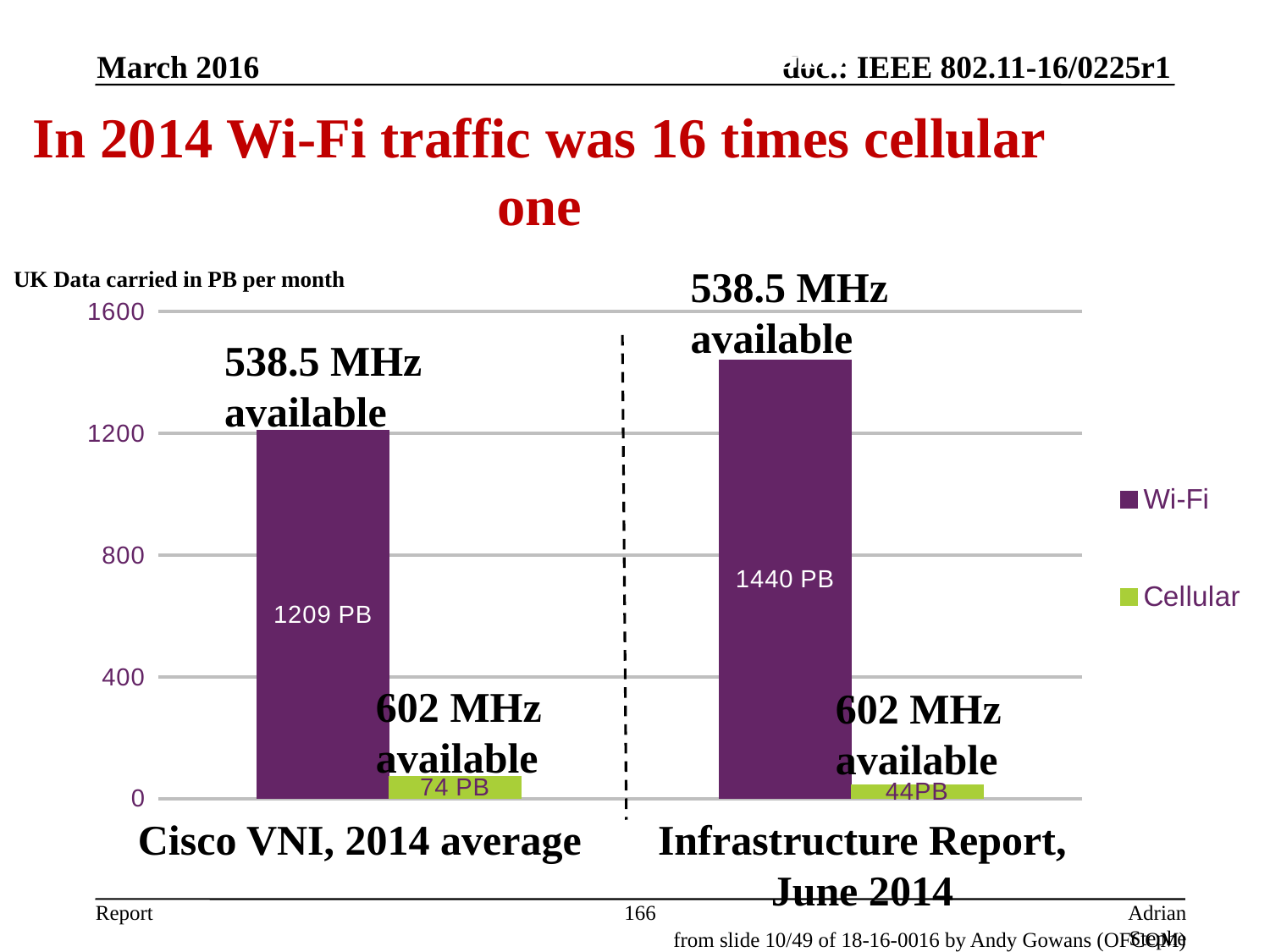
What is the Cellular value for Infrastructure Report, June 2014? 44PB Which category has the lower Cellular value? Infrastructure Report, June 2014 Which series is shown in green in the legend? Cellular Is the Wi-Fi value for Cisco VNI, 2014 average greater or less than 1200? greater What is the Cellular value for Cisco VNI, 2014 average? 74 PB What is the Wi-Fi value for Infrastructure Report, June 2014? 1440 PB What is the Wi-Fi value for Cisco VNI, 2014 average? 1209 PB What is the difference between the Wi-Fi values for Infrastructure Report, June 2014 and Cisco VNI, 2014 average? 231 PB Which category has the higher Wi-Fi value? Infrastructure Report, June 2014 How many categories are shown on the x axis? 2 What kind of chart is shown on the slide? bar chart How many series does the legend list? 2